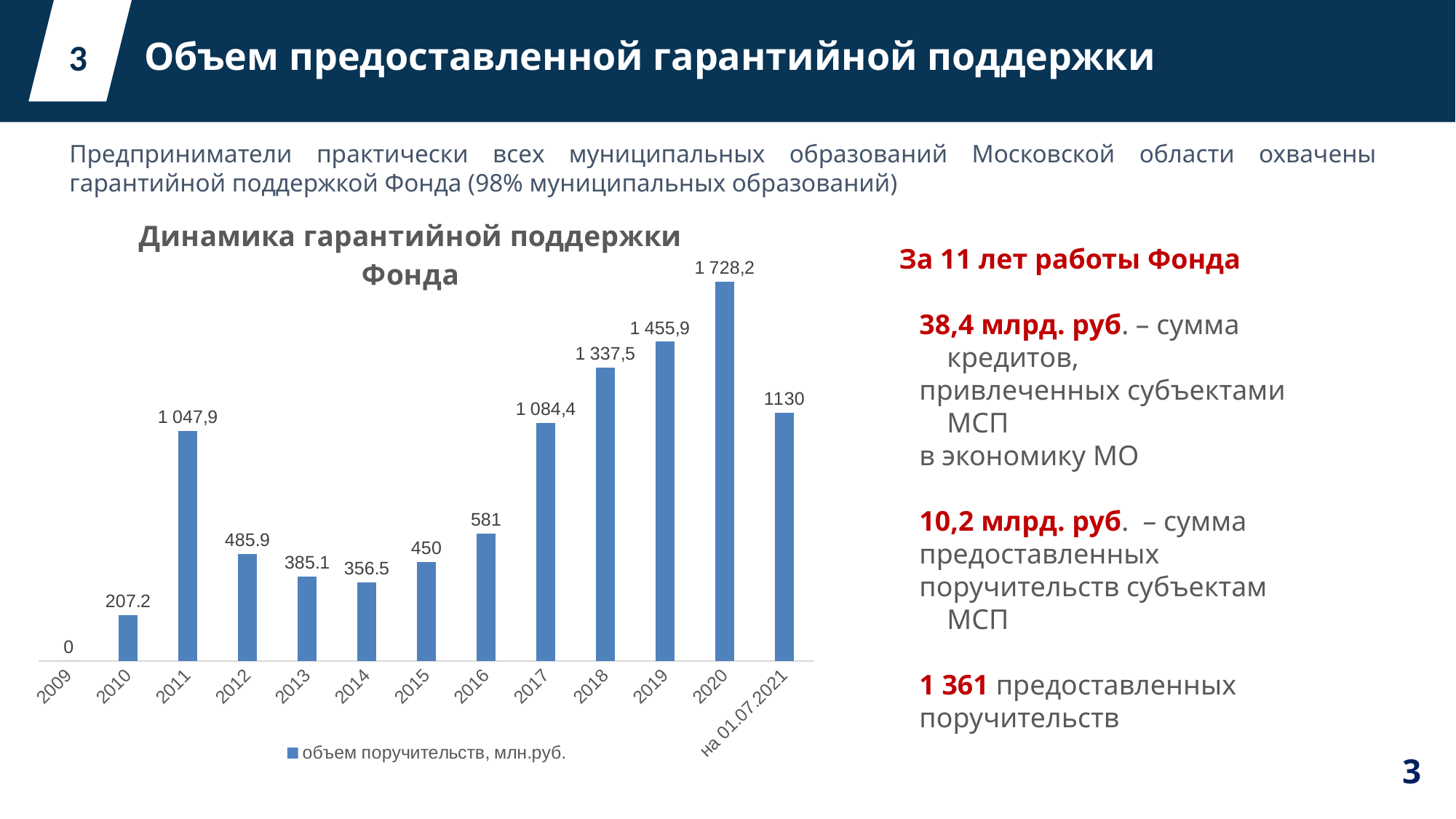
What is the value for на 01.07.2021 in the chart? 1130 Which year has the lowest value in the chart? 2009 How many categories are shown on the x axis of the chart? 13 What is the value for 2020 in the chart? 1 728,2 Which is larger, the value for 2011 or the value for 2017? 2017 What is the value for 2014 in the chart? 356.5 What kind of chart is shown on the slide? bar chart What is the difference between the values for 2020 and 2019? 272,3 What is the difference between the values for 2016 and 2015? 131 What is the legend entry of the chart? объем поручительств, млн.руб. Which year has the highest value in the chart? 2020 What is the value for 2011 in the chart? 1 047,9